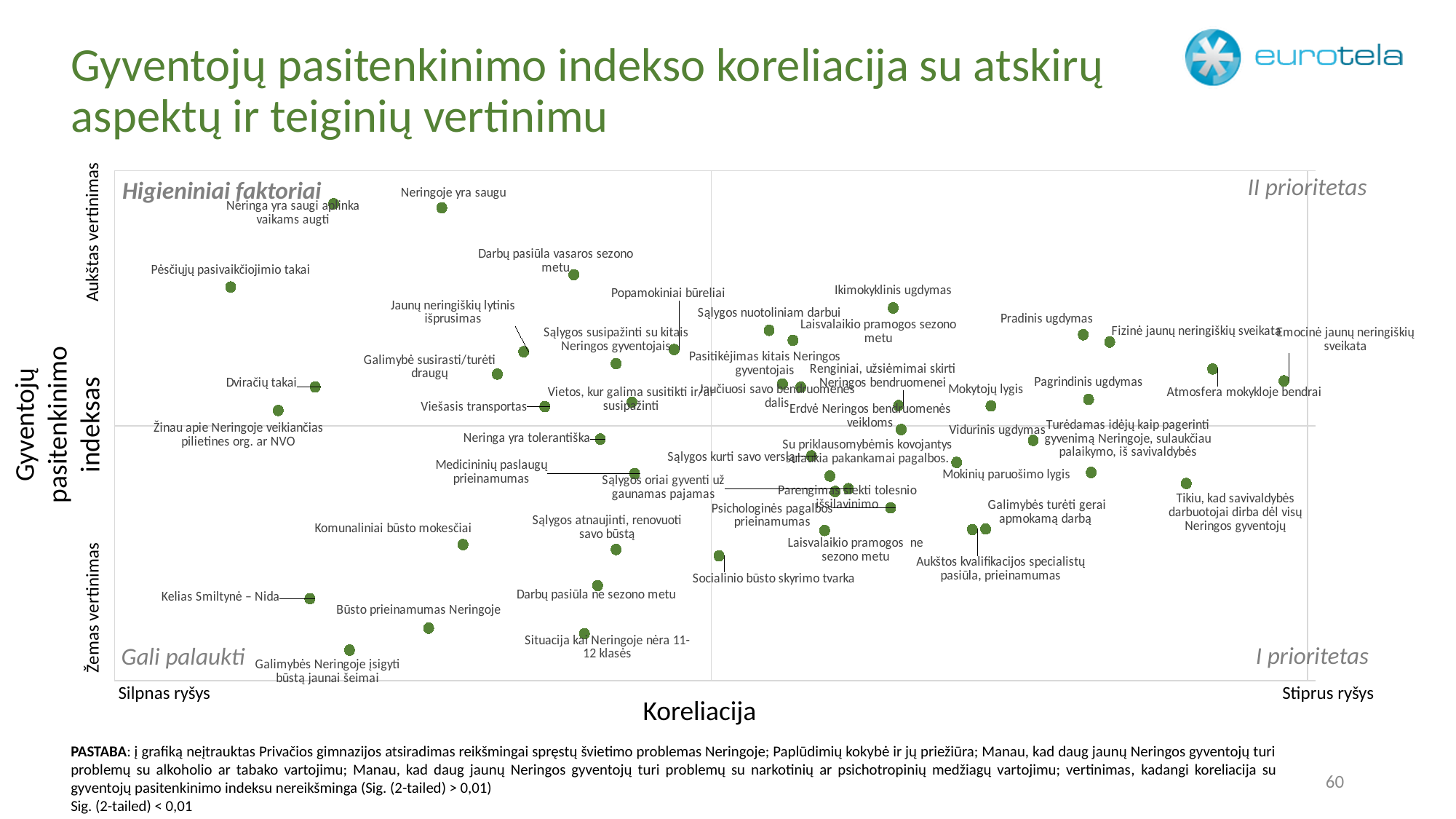
What is the label of the horizontal axis of the chart? Koreliacija Which point is plotted furthest to the left (weakest correlation)? Pėsčiųjų pasivaikščiojimo takai Which has a higher satisfaction index: 'Pėsčiųjų pasivaikščiojimo takai' or 'Dviračių takai'? Pėsčiųjų pasivaikščiojimo takai What kind of chart is shown on the slide? scatter chart Which has a stronger correlation: 'Pradinis ugdymas' or 'Dviračių takai'? Pradinis ugdymas Which point is plotted furthest to the right (strongest correlation)? Emocinė jaunų neringiškių sveikata What label is shown in the bottom-right quadrant of the chart? I prioritetas In which quadrant of the chart is 'Pradinis ugdymas' plotted? II prioritetas Which point is plotted lowest on the vertical axis (lowest satisfaction index)? Galimybės Neringoje įsigyti būstą jaunai šeimai In which quadrant of the chart is 'Kelias Smiltynė – Nida' plotted? Gali palaukti In which quadrant of the chart is 'Tikiu, kad savivaldybės darbuotojai dirba dėl visų Neringos gyventojų' plotted? I prioritetas Which has a higher satisfaction index: 'Neringoje yra saugu' or 'Kelias Smiltynė – Nida'? Neringoje yra saugu